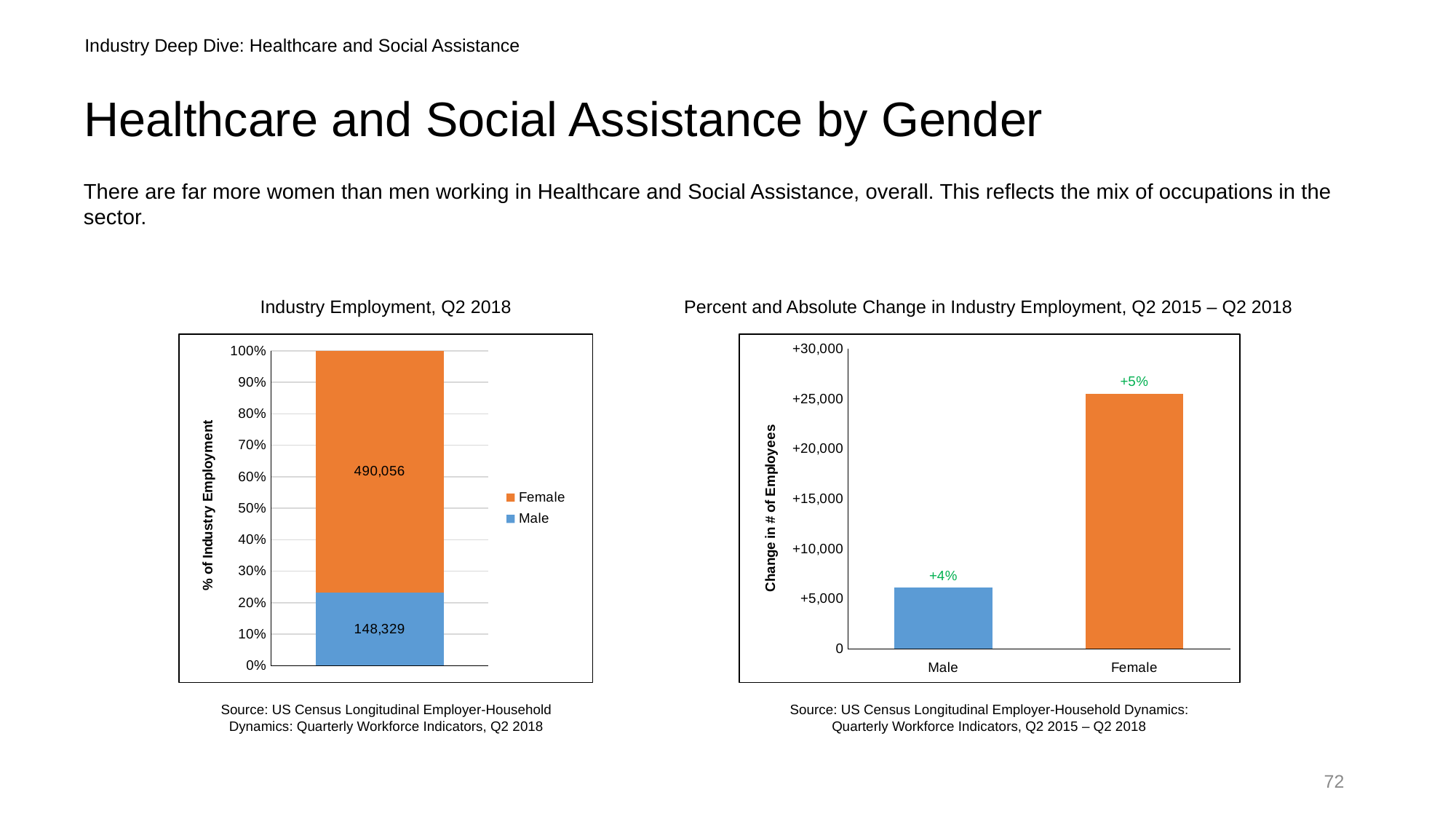
In the 'Percent and Absolute Change in Industry Employment, Q2 2015 – Q2 2018' chart, what percent change is labelled above the Male bar? +4% In the 'Industry Employment, Q2 2018' chart, what is the value labelled on the Male segment? 148,329 In the 'Industry Employment, Q2 2018' chart, what is the difference between the Female and Male values? 341,727 In the 'Industry Employment, Q2 2018' chart, which segment is larger, Female or Male? Female In the 'Percent and Absolute Change in Industry Employment, Q2 2015 – Q2 2018' chart, is the value for Male greater or less than +10,000? less What kind of chart is the 'Industry Employment, Q2 2018' chart? Stacked bar chart In the 'Industry Employment, Q2 2018' chart, what is the value labelled on the Female segment? 490,056 In the 'Percent and Absolute Change in Industry Employment, Q2 2015 – Q2 2018' chart, which category has the highest change in number of employees? Female In the 'Percent and Absolute Change in Industry Employment, Q2 2015 – Q2 2018' chart, what percent change is labelled above the Female bar? +5% In the 'Industry Employment, Q2 2018' chart, how many series does the legend list? 2 In the 'Percent and Absolute Change in Industry Employment, Q2 2015 – Q2 2018' chart, is the value for Female greater or less than +20,000? greater In the 'Industry Employment, Q2 2018' chart, what is the total of the Female and Male segments in the stacked bar? 638,385